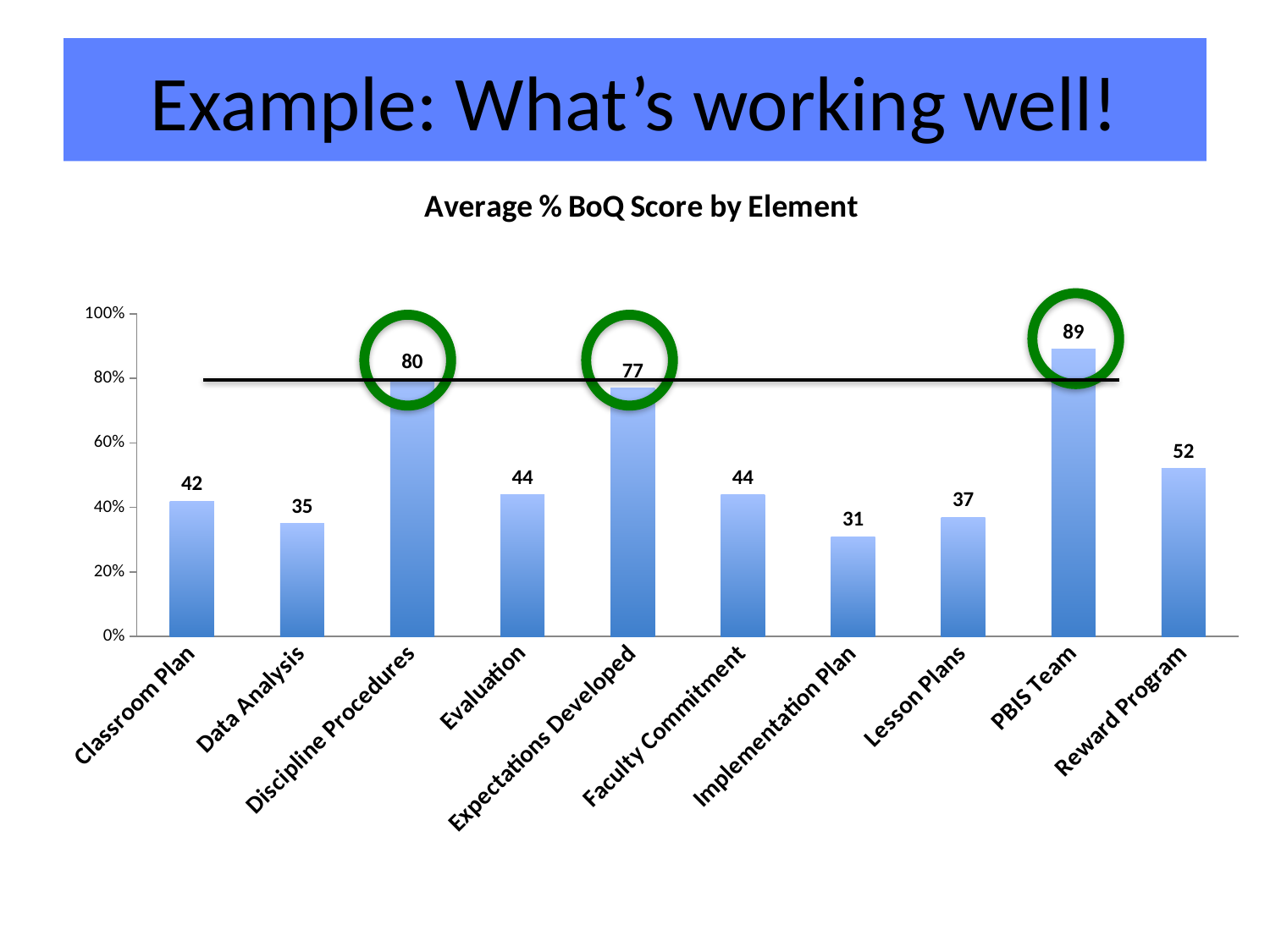
What is the value for Reward Program? 52 What is the value for PBIS Team? 89 What is the value for Implementation Plan? 31 What kind of chart is shown on the slide? bar chart What is the difference between the values for Discipline Procedures and Expectations Developed? 3 Which element has the highest average % BoQ score? PBIS Team How many elements are shown on the x axis? 10 What is the title of the chart? Average % BoQ Score by Element How many bars are circled in green? 3 Which is larger, the value for Classroom Plan or the value for Data Analysis? Classroom Plan Is the value for Lesson Plans greater or less than 40%? less Which element has the lowest average % BoQ score? Implementation Plan